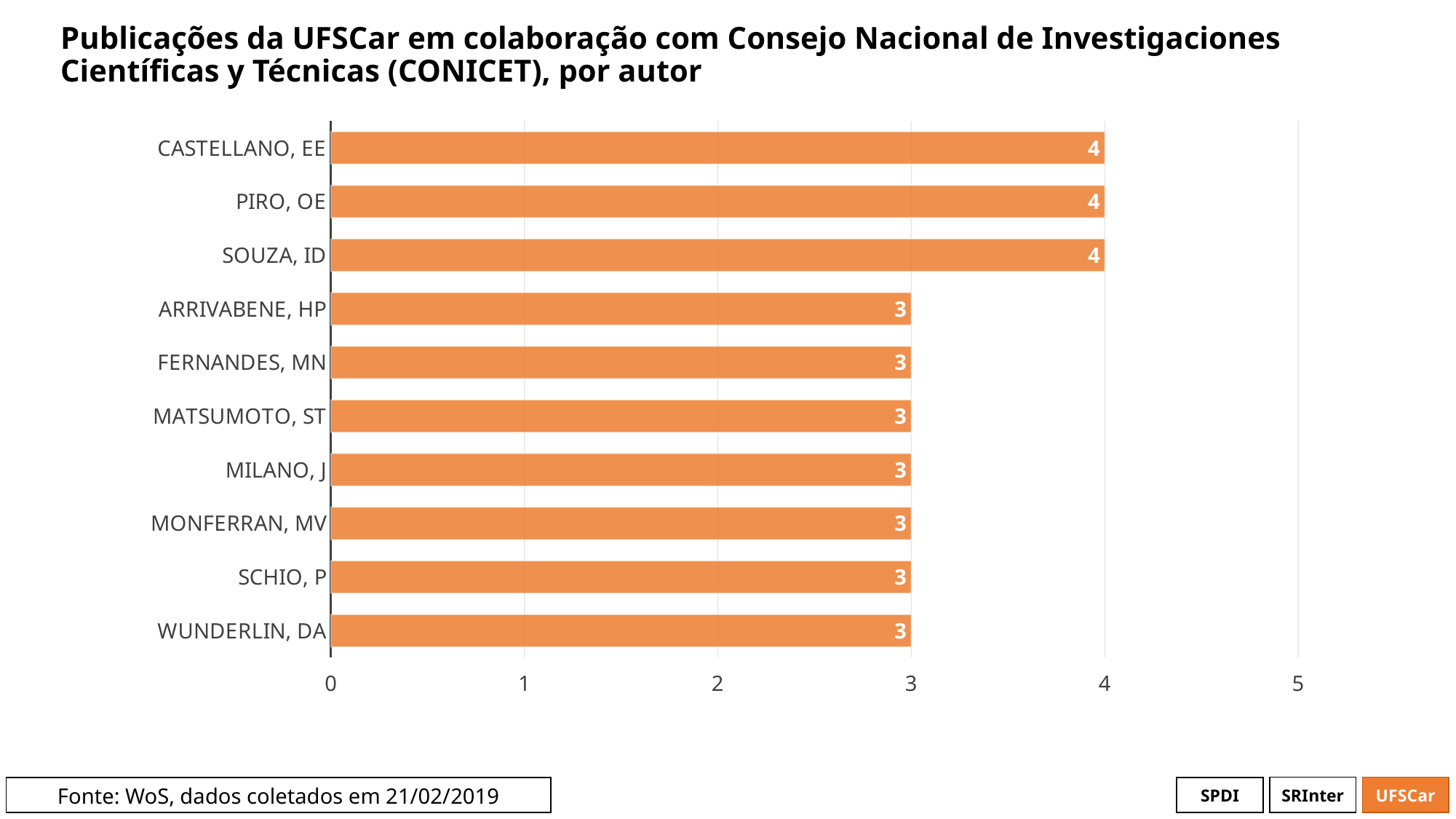
What is the value for CASTELLANO, EE? 4 How many authors have a value of 4? 3 What is the value for ARRIVABENE, HP? 3 Is the value for MATSUMOTO, ST greater or less than 4? less What is the difference between the values for PIRO, OE and SCHIO, P? 1 Which is larger, the value for SOUZA, ID or the value for MILANO, J? SOUZA, ID What colour are the bars in the chart? orange What is the value for SOUZA, ID? 4 What is the value for WUNDERLIN, DA? 3 What kind of chart is shown on the slide? bar chart How many authors are shown in the chart? 10 What is the source of the data stated on the slide? WoS, dados coletados em 21/02/2019